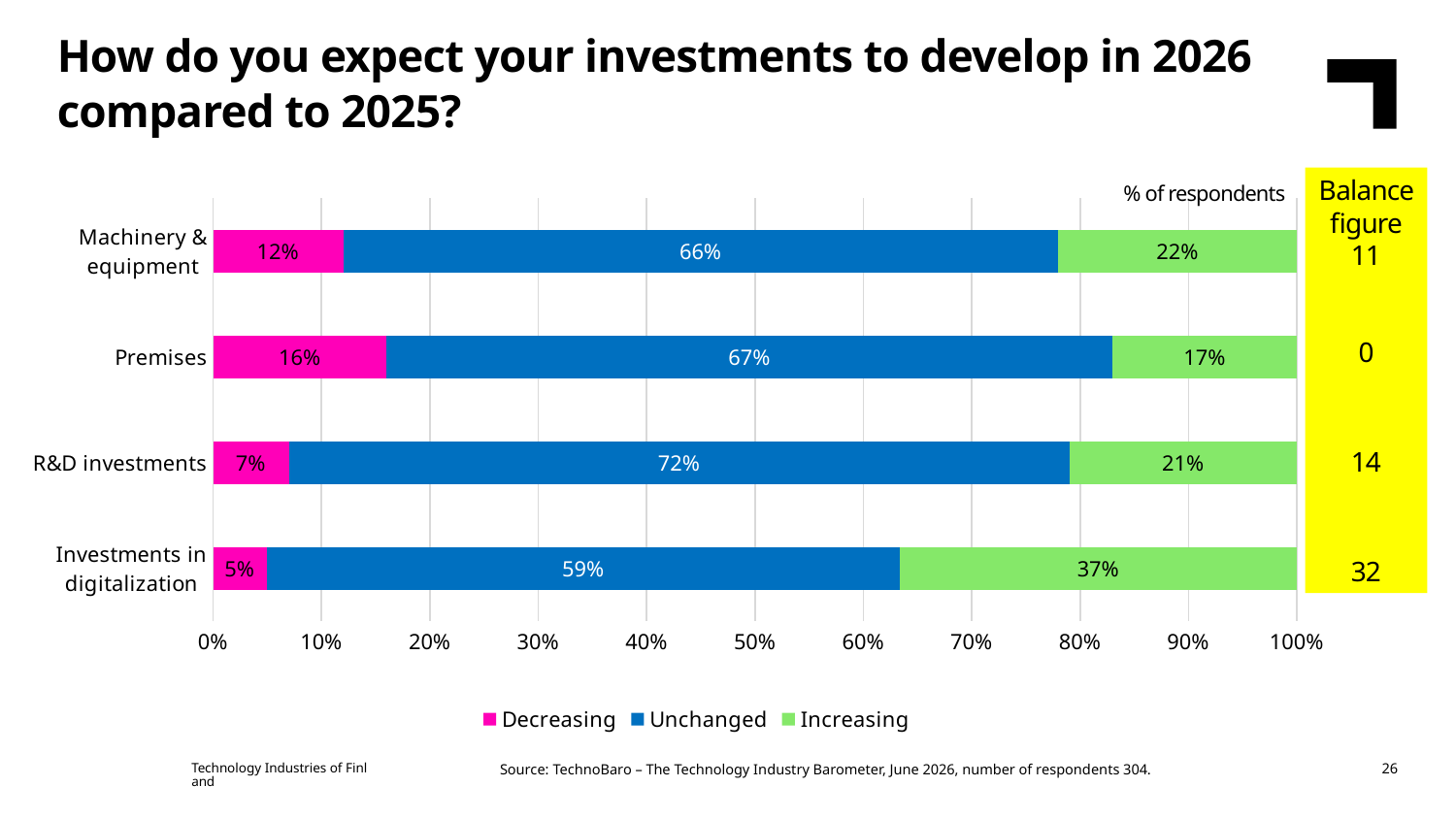
Which is larger: the Unchanged share for R&D investments or for Premises? R&D investments What percentage of respondents expect Premises investments to be Decreasing? 16% What percentage of respondents expect Machinery & equipment investments to be Unchanged? 66% How many series does the legend list? 3 How many categories are shown on the chart? 4 Which category has the lowest share of respondents expecting Decreasing investments? Investments in digitalization What colour represents the Decreasing series in the chart? Magenta (pink) What kind of chart is shown on the slide? Stacked bar chart Which category has the highest share of respondents expecting Increasing investments? Investments in digitalization What is the balance figure shown for R&D investments? 14 What percentage of respondents expect Investments in digitalization to be Increasing? 37% What is the difference between the Increasing share for Investments in digitalization and for Premises? 20%